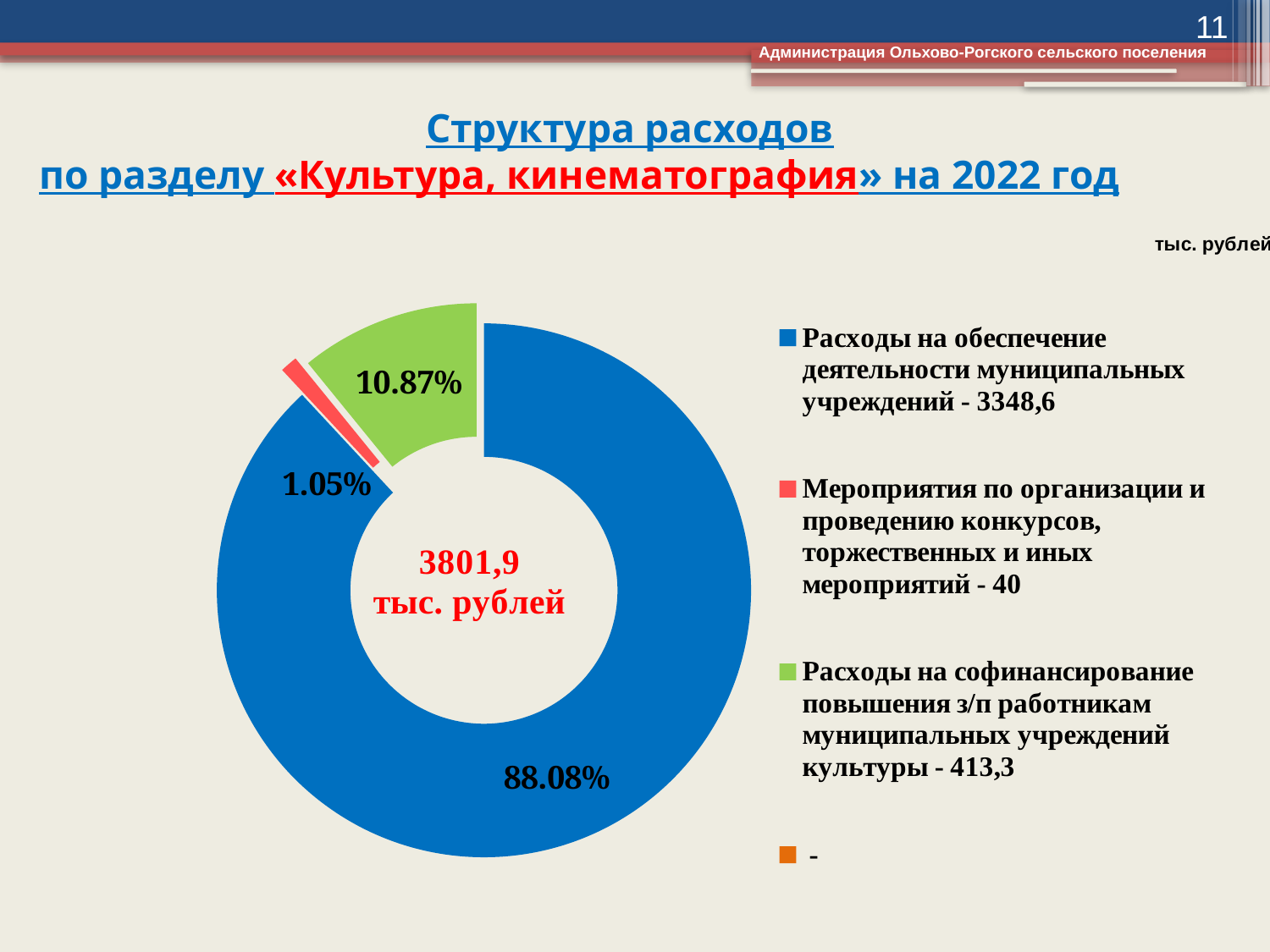
What is the difference between the values for «Расходы на обеспечение деятельности муниципальных учреждений» (3348,6) and «Расходы на софинансирование повышения з/п работникам муниципальных учреждений культуры» (413,3)? 2935,3 What share of the chart does the slice for «Расходы на обеспечение деятельности муниципальных учреждений» represent? 88.08% What is the value (тыс. рублей) for «Расходы на обеспечение деятельности муниципальных учреждений» according to the legend? 3348,6 What share of the chart does the slice for «Мероприятия по организации и проведению конкурсов, торжественных и иных мероприятий» represent? 1.05% What is the total amount shown in the centre of the chart? 3801,9 тыс. рублей What kind of chart is shown on the slide? doughnut (pie) chart What is the value (тыс. рублей) for «Расходы на софинансирование повышения з/п работникам муниципальных учреждений культуры» according to the legend? 413,3 How many slices with percentage labels does the chart have? 3 What share of the chart does the slice for «Расходы на софинансирование повышения з/п работникам муниципальных учреждений культуры» represent? 10.87% Which category has the largest slice of the chart? Расходы на обеспечение деятельности муниципальных учреждений Which category has the smallest slice of the chart? Мероприятия по организации и проведению конкурсов, торжественных и иных мероприятий What is the value (тыс. рублей) for «Мероприятия по организации и проведению конкурсов, торжественных и иных мероприятий» according to the legend? 40